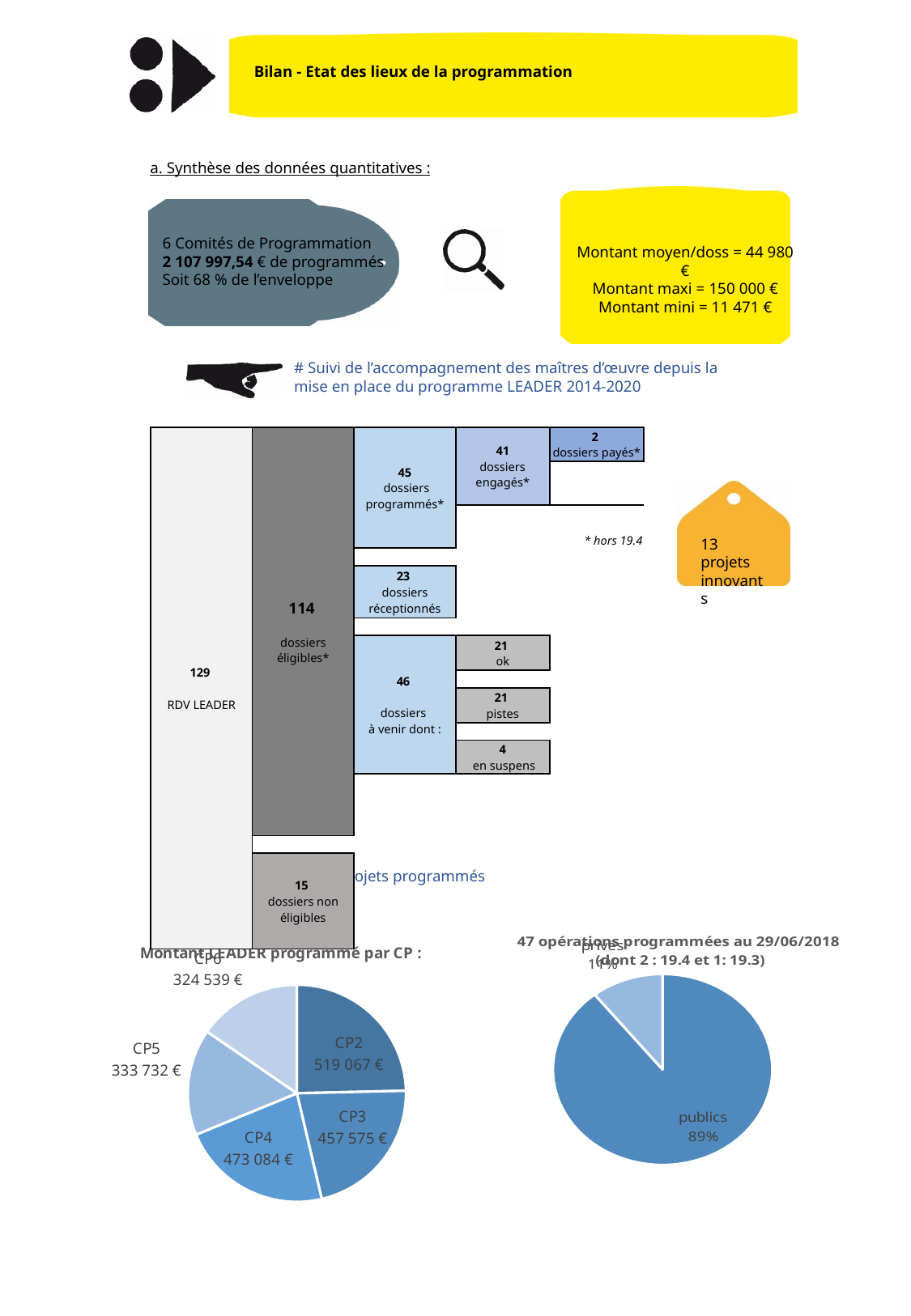
What kind of chart is 'Montant LEADER programmé par CP'? Pie chart In the pie chart '47 opérations programmées au 29/06/2018', what share is 'publics'? 89% In the pie chart 'Montant LEADER programmé par CP', which CP has the highest amount? CP2 In the pie chart 'Montant LEADER programmé par CP', what is the difference between CP2 and CP3? 61 492 € How many slices does the pie chart 'Montant LEADER programmé par CP' have? 5 In the pie chart 'Montant LEADER programmé par CP', which is larger, CP3 or CP4? CP4 In the pie chart 'Montant LEADER programmé par CP', what is the value for CP2? 519 067 € In the pie chart 'Montant LEADER programmé par CP', what is the value for CP5? 333 732 € In the pie chart 'Montant LEADER programmé par CP', what is the value for CP4? 473 084 € In the pie chart '47 opérations programmées au 29/06/2018', what share is 'privés'? 11% How many slices does the pie chart '47 opérations programmées au 29/06/2018' have? 2 In the pie chart 'Montant LEADER programmé par CP', which CP has the lowest amount? CP6